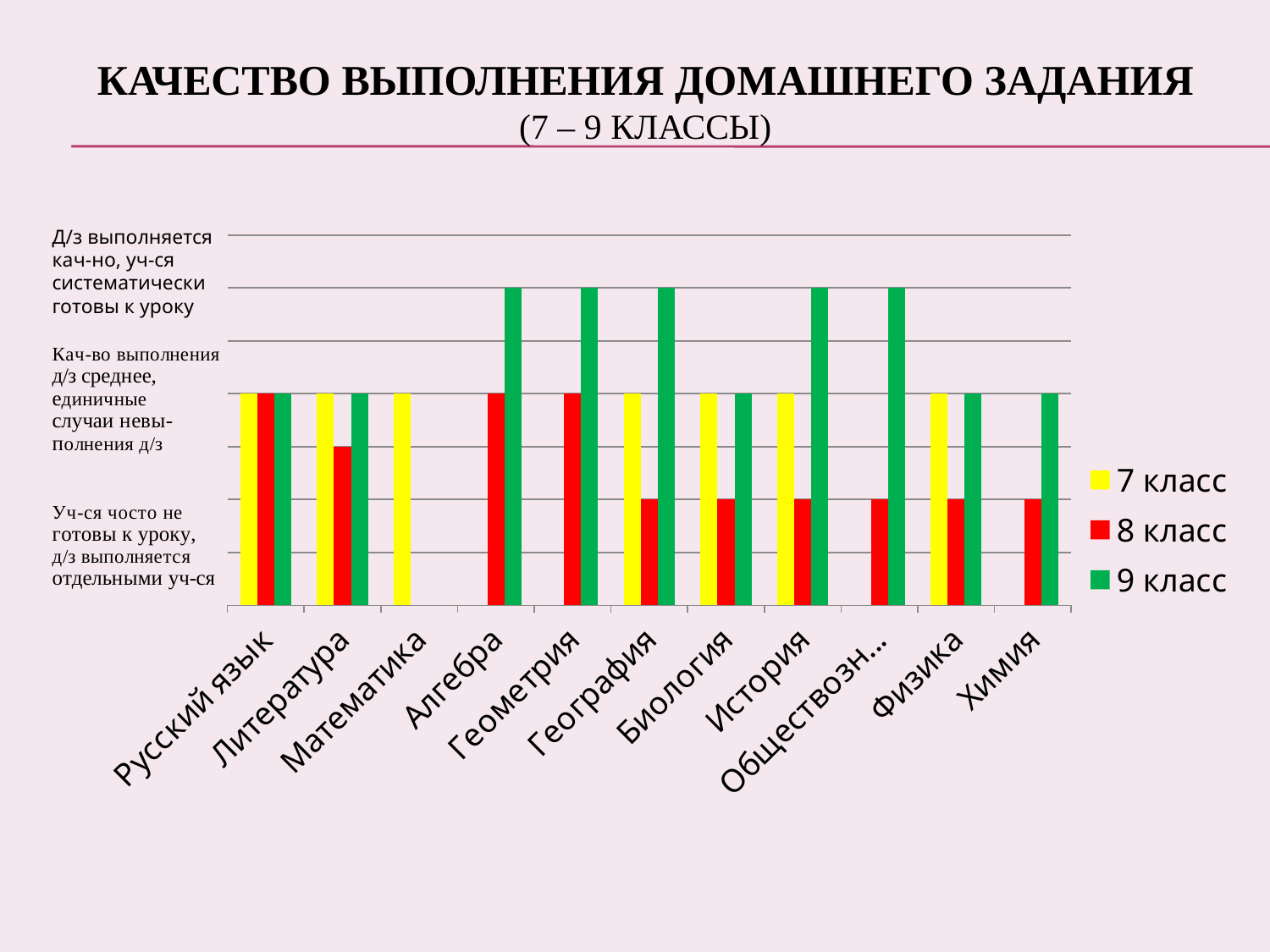
What kind of chart is shown on the slide? bar chart For Литература, which is larger: the bar for 7 класс or the bar for 8 класс? 7 класс For Алгебра, which is larger: the bar for 8 класс or the bar for 9 класс? 9 класс How many subject categories are shown along the x axis? 11 For История, which series has the tallest bar? 9 класс What are the three series named in the legend? 7 класс, 8 класс, 9 класс Which subject has a bar only for 7 класс? Математика What colour represents 8 класс in the chart? red For Физика, which is larger: the bar for 7 класс or the bar for 8 класс? 7 класс For География, which series has the lowest bar? 8 класс How many series does the legend list? 3